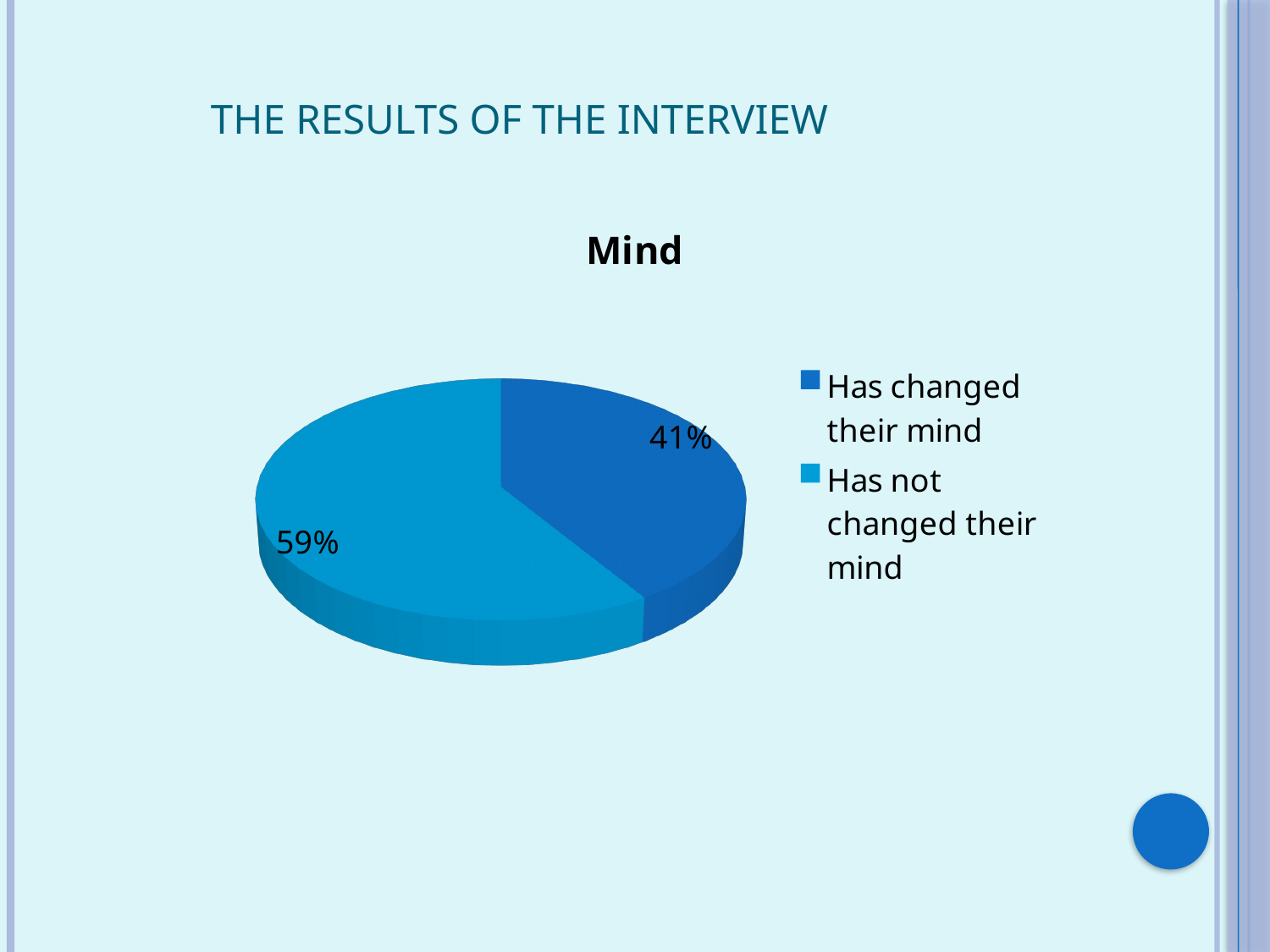
What share of the pie is labelled "Has not changed their mind"? 59% Which is larger: the share for "Has changed their mind" or the share for "Has not changed their mind"? Has not changed their mind Which category has the smallest share of the pie? Has changed their mind How many slices does the pie chart have? 2 What is the difference in percentage points between the "Has not changed their mind" and "Has changed their mind" slices? 18% What kind of chart is shown on the slide? pie chart What is the total of the two slices shown on the pie chart? 100% Is the share for "Has changed their mind" greater or less than 50%? less Which category has the largest share of the pie? Has not changed their mind How many entries does the legend list? 2 What is the title of the chart? Mind What share of the pie is labelled "Has changed their mind"? 41%